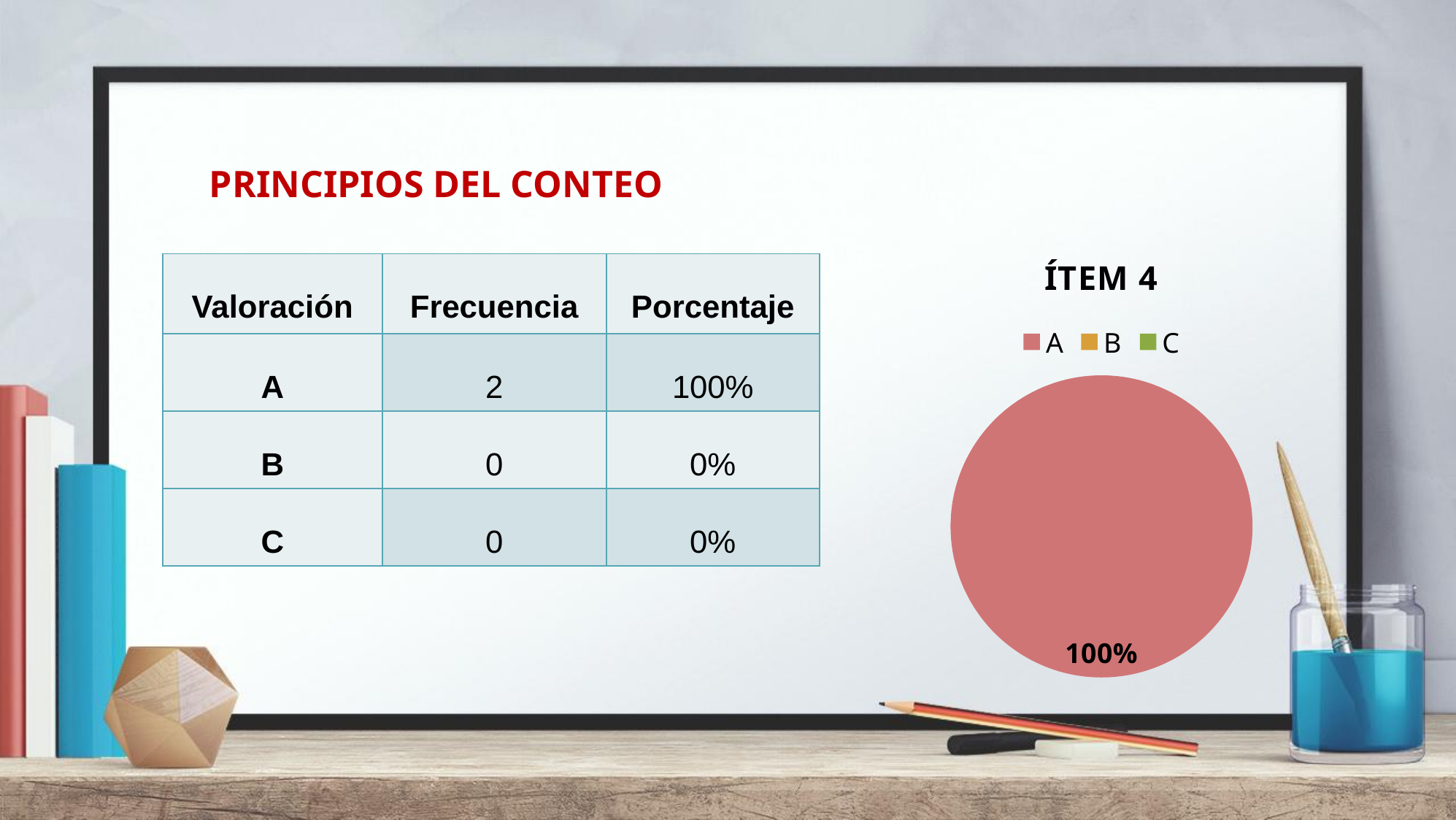
How many entries does the chart legend list? 3 What is the title of the chart? ÍTEM 4 Is the share for A larger or smaller than the share for B? larger What share of the pie does category A take? 100% Which category has the largest slice of the pie? A What percentage label is printed on the pie? 100% Is the value for A greater or less than 50%? greater Which legend entries are listed for the chart? A, B, C What kind of chart is shown on the slide? pie chart